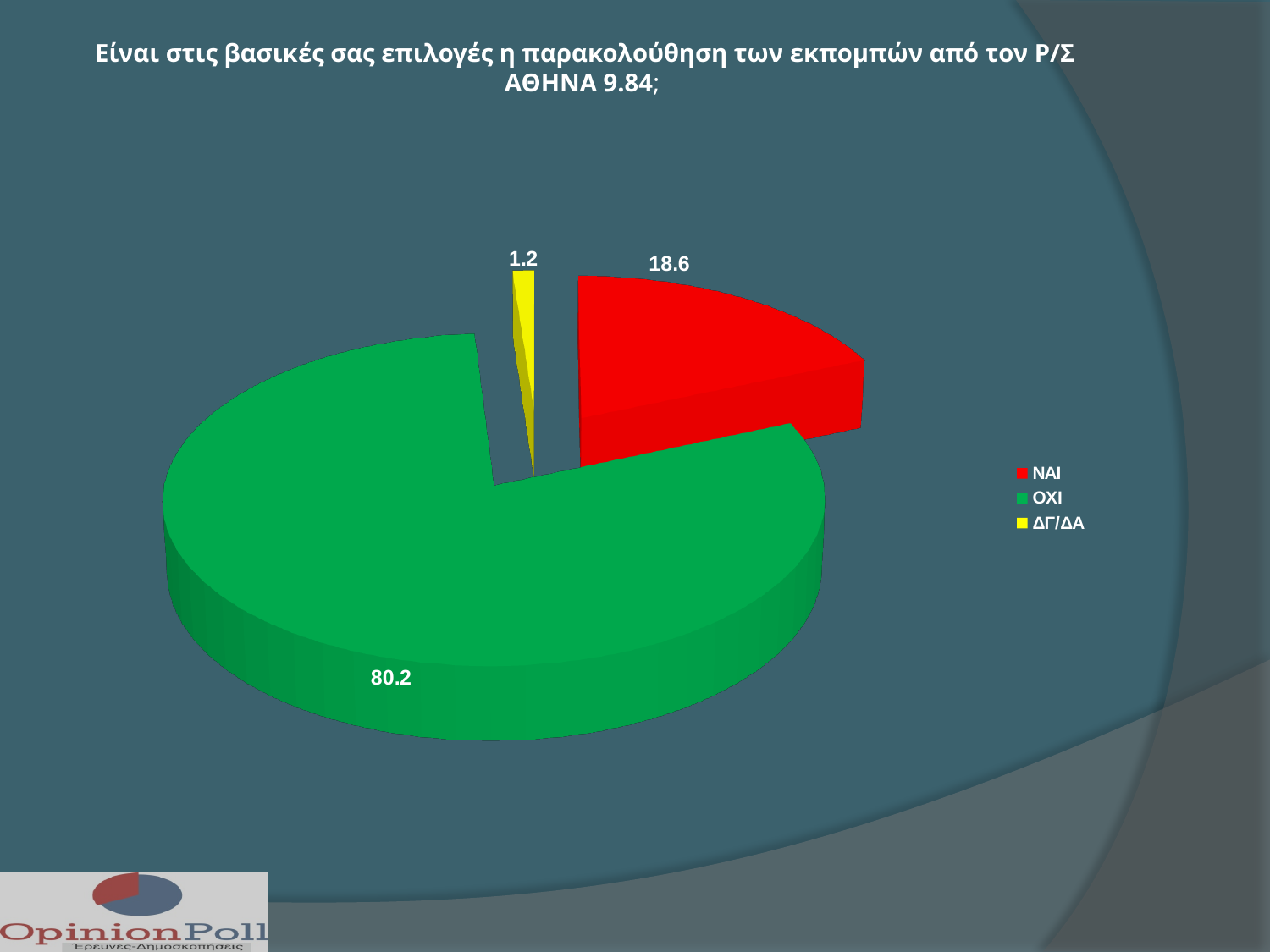
What colour is the slice for ΝΑΙ? Red Which category has the smallest slice? ΔΓ/ΔΑ Which is larger, the value for ΝΑΙ or the value for ΟΧΙ? ΟΧΙ What kind of chart is shown on the slide? Pie chart What is the difference between the values for ΝΑΙ and ΔΓ/ΔΑ? 17.4 What is the value for ΝΑΙ? 18.6 What is the difference between the values for ΟΧΙ and ΝΑΙ? 61.6 How many categories does the legend list? 3 What is the value for ΔΓ/ΔΑ? 1.2 What is the value for ΟΧΙ? 80.2 What colour is the slice for ΔΓ/ΔΑ? Yellow Which category has the largest slice? ΟΧΙ